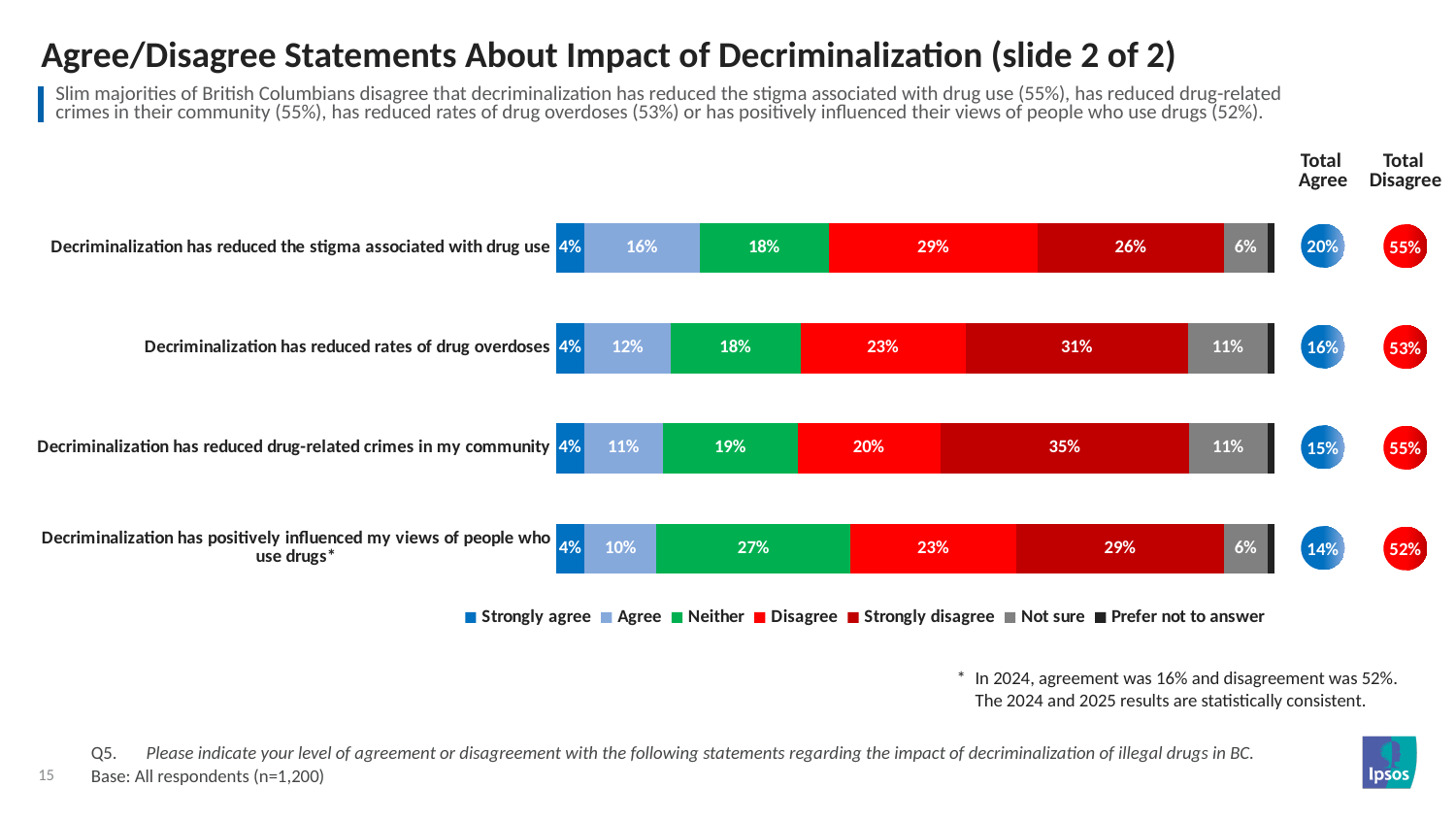
What is the Total Agree value for the statement that decriminalization has reduced the stigma associated with drug use? 20% What colour represents 'Strongly disagree' in the chart? Dark red What is the 'Not sure' percentage for the statement that decriminalization has reduced rates of drug overdoses? 11% How many response categories does the legend list? 7 Which statement has the highest 'Strongly disagree' percentage? Decriminalization has reduced drug-related crimes in my community What type of chart is shown on the slide? Stacked bar chart What is the difference between the 'Disagree' percentage for the stigma statement and the 'Disagree' percentage for the drug-related crimes statement? 9% What percentage of respondents 'Strongly disagree' that decriminalization has reduced drug-related crimes in my community? 35% Which statement has the lowest Total Agree value? Decriminalization has positively influenced my views of people who use drugs What percentage of respondents answered 'Neither' for the statement that decriminalization has positively influenced my views of people who use drugs? 27% How many statements are shown in the chart? 4 Which is larger: the 'Agree' percentage for the stigma statement or the 'Agree' percentage for the drug overdoses statement? The stigma statement (16%)